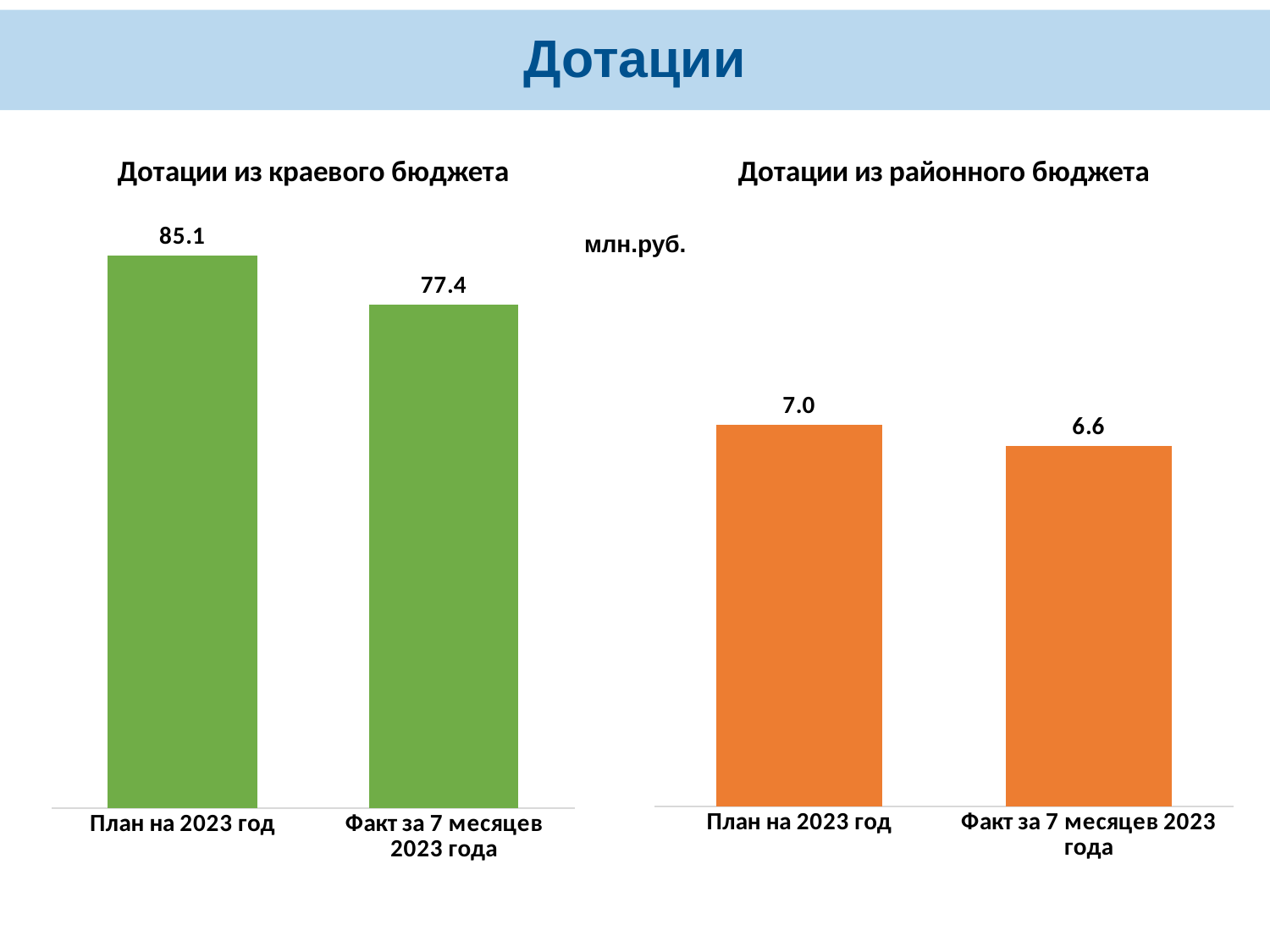
How many bars are in the chart 'Дотации из краевого бюджета'? 2 In the chart 'Дотации из районного бюджета', which category has the lowest value? Факт за 7 месяцев 2023 года In the chart 'Дотации из районного бюджета', what is the value for 'План на 2023 год'? 7.0 In the chart 'Дотации из краевого бюджета', what is the value for 'Факт за 7 месяцев 2023 года'? 77.4 In the chart 'Дотации из краевого бюджета', what is the value for 'План на 2023 год'? 85.1 In the chart 'Дотации из районного бюджета', what is the value for 'Факт за 7 месяцев 2023 года'? 6.6 In the chart 'Дотации из краевого бюджета', what is the difference between 'План на 2023 год' and 'Факт за 7 месяцев 2023 года'? 7.7 What unit is shown on the slide for the chart values? млн.руб. In the chart 'Дотации из районного бюджета', what is the difference between 'План на 2023 год' and 'Факт за 7 месяцев 2023 года'? 0.4 What kind of chart is 'Дотации из районного бюджета'? Bar chart In the chart 'Дотации из краевого бюджета', which category has the highest value? План на 2023 год In the chart 'Дотации из районного бюджета', which is larger: 'План на 2023 год' or 'Факт за 7 месяцев 2023 года'? План на 2023 год